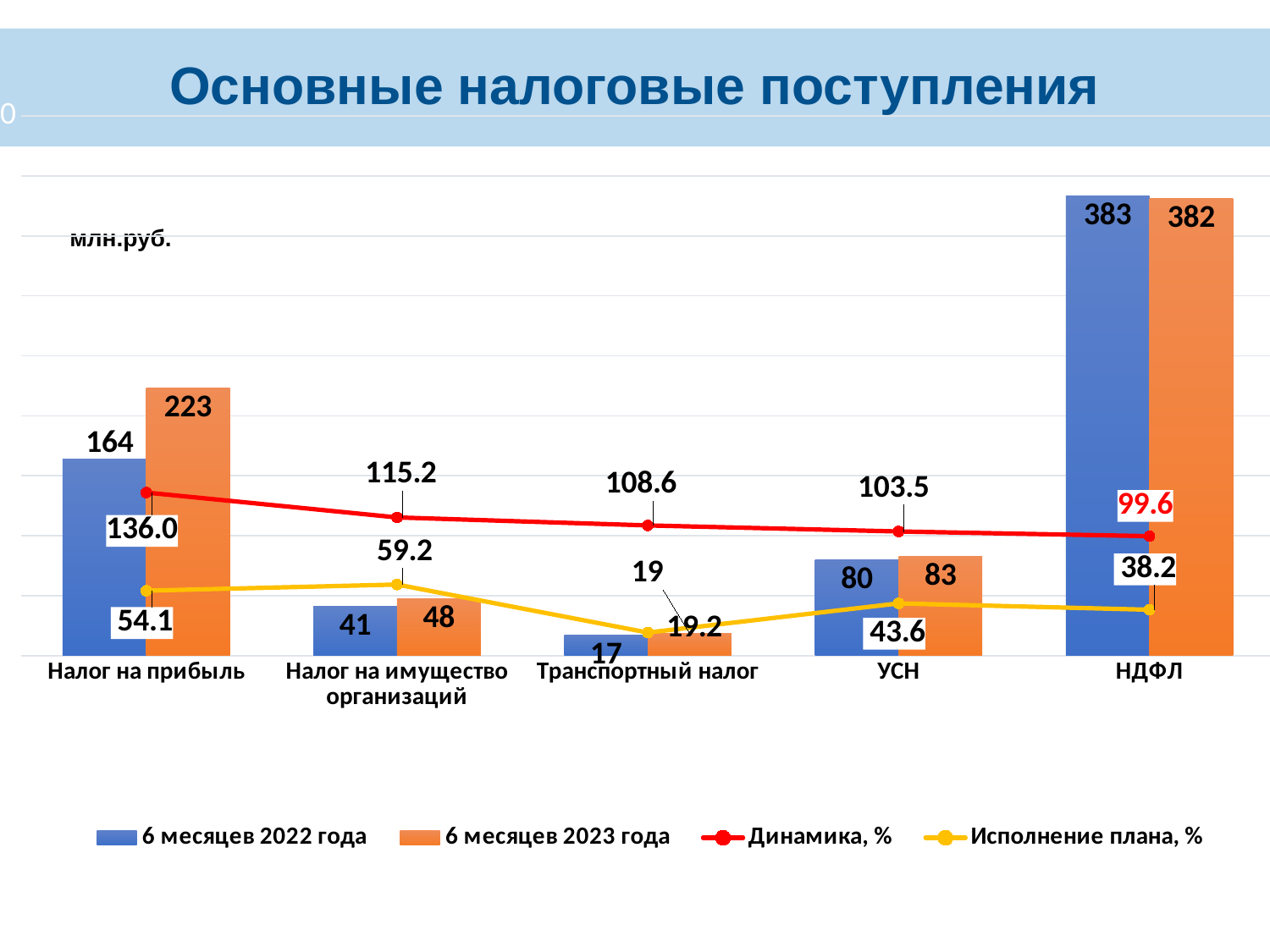
What is the title of the chart? Основные налоговые поступления What is the value for НДФЛ in the 6 месяцев 2022 года series? 383 Does the Динамика, % line rise or fall from Налог на прибыль to НДФЛ? fall What is the difference between the 6 месяцев 2023 года and 6 месяцев 2022 года values for Налог на прибыль? 59 How many tax categories are shown on the x axis? 5 Which is larger for УСН: the 6 месяцев 2022 года value or the 6 месяцев 2023 года value? 6 месяцев 2023 года What is the Исполнение плана, % value for УСН? 43.6 How many series does the legend list? 4 Which category has the lowest value in the 6 месяцев 2022 года series? Транспортный налог What is the Динамика, % value for Налог на имущество организаций? 115.2 Which category has the highest value in the 6 месяцев 2023 года series? НДФЛ What is the value for Налог на прибыль in the 6 месяцев 2023 года series? 223